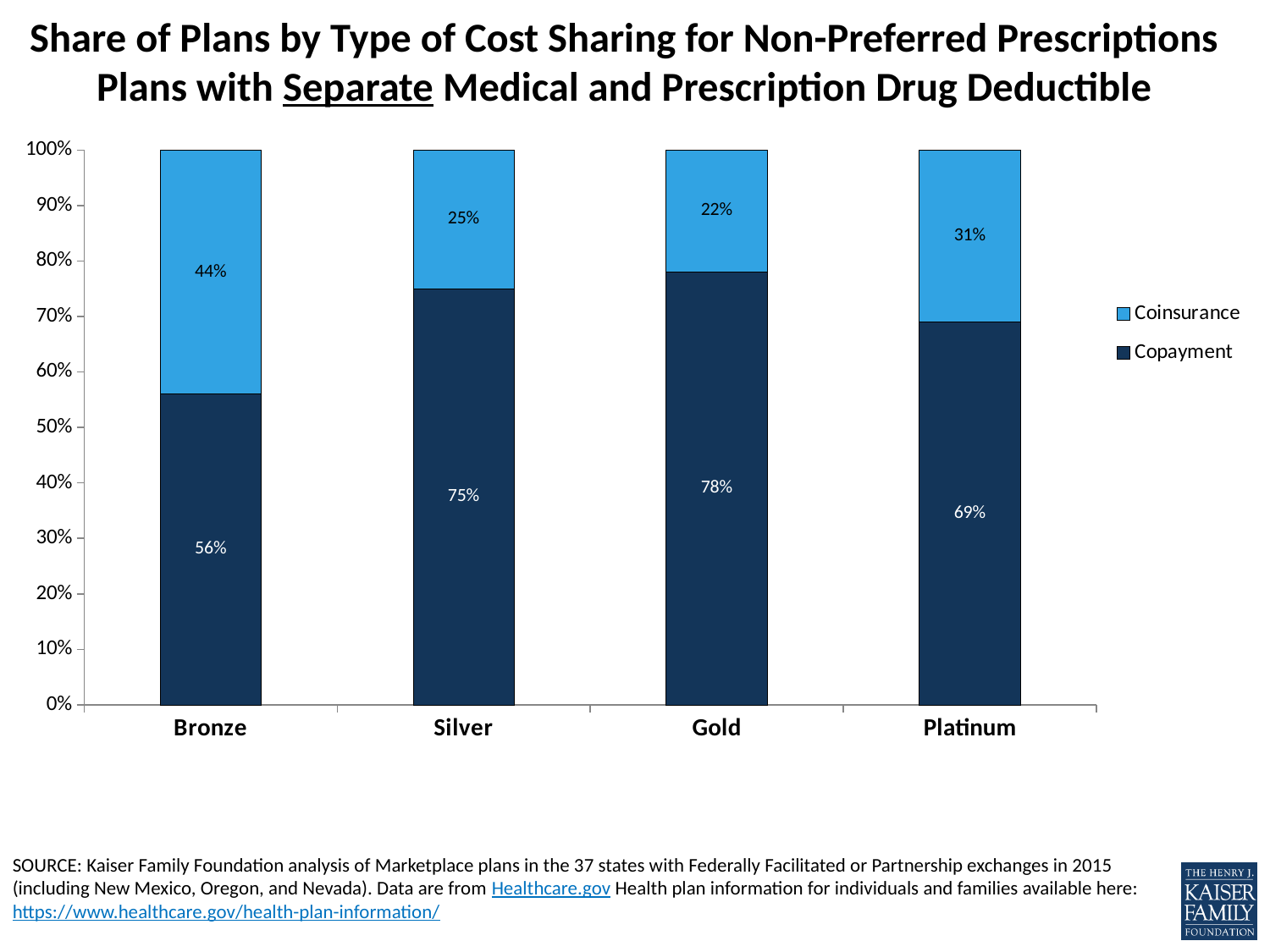
What is the Coinsurance share for Gold plans? 22% What is the Copayment share for Bronze plans? 56% What kind of chart is shown on the slide? Stacked bar chart How many plan types are shown on the x axis? 4 How many series does the legend list? 2 What is the Copayment share for Platinum plans? 69% What is the Coinsurance share for Silver plans? 25% Which is larger: the Coinsurance share for Platinum or the Coinsurance share for Silver? Platinum Which plan type has the highest Copayment share? Gold Which plan type has the lowest Coinsurance share? Gold Which plan type has the highest Coinsurance share? Bronze What is the difference between the Copayment share for Silver and the Copayment share for Bronze? 19%